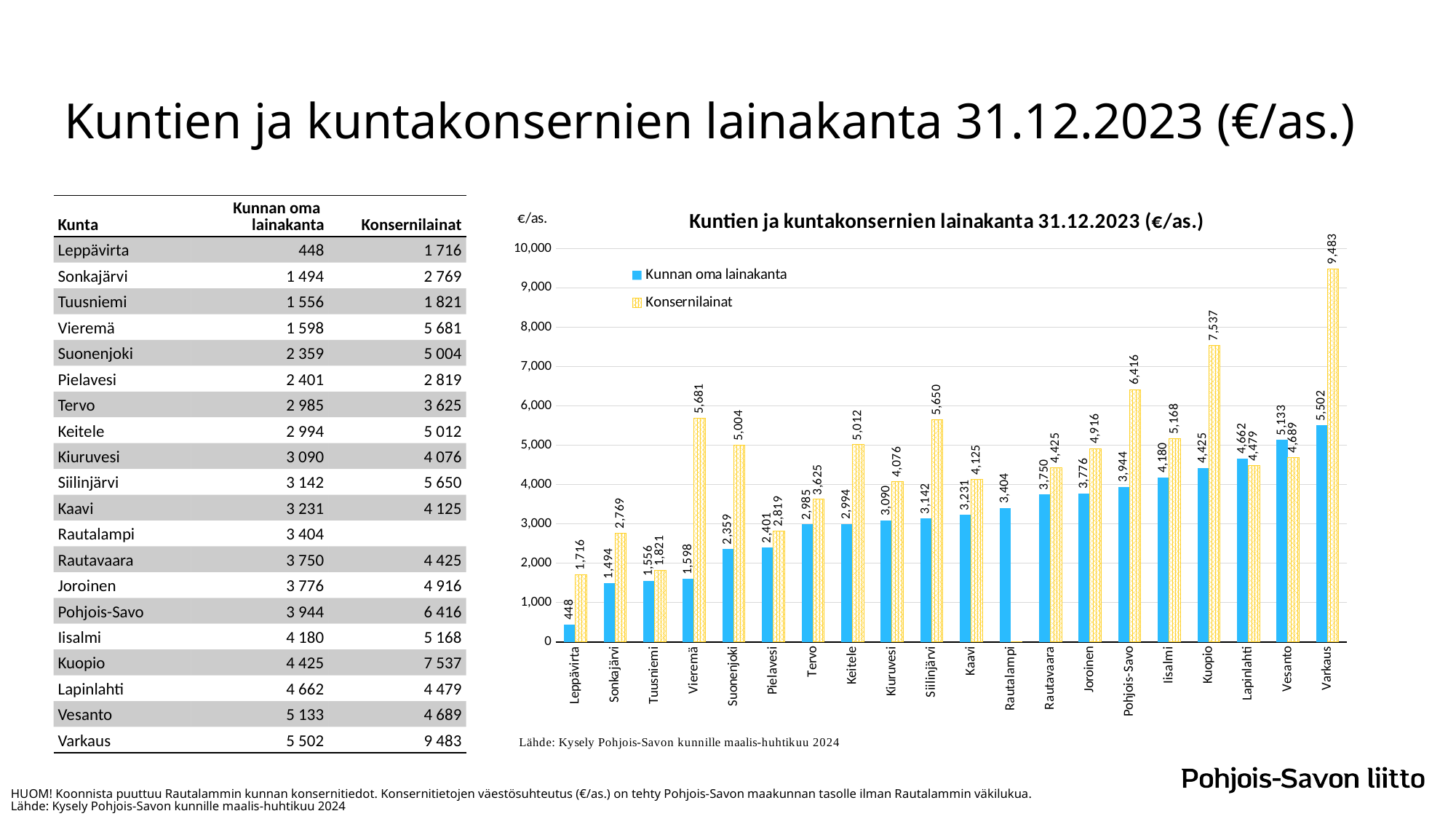
Which municipality has the highest Konsernilainat value? Varkaus What is the Kunnan oma lainakanta value for Pohjois-Savo? 3,944 How many series does the chart legend list? 2 How many municipalities/categories are shown on the x axis of the chart? 20 What is the Kunnan oma lainakanta value for Leppävirta? 448 Which municipality has no Konsernilainat bar in the chart? Rautalampi What kind of chart is shown on the slide? Bar chart What is the Konsernilainat value for Varkaus? 9,483 What is the difference between the Konsernilainat and Kunnan oma lainakanta values for Kuopio? 3,112 Is the Konsernilainat value for Vieremä greater or less than 5,000? greater Which is larger for Lapinlahti: Kunnan oma lainakanta or Konsernilainat? Kunnan oma lainakanta Which municipality has the lowest Kunnan oma lainakanta value? Leppävirta